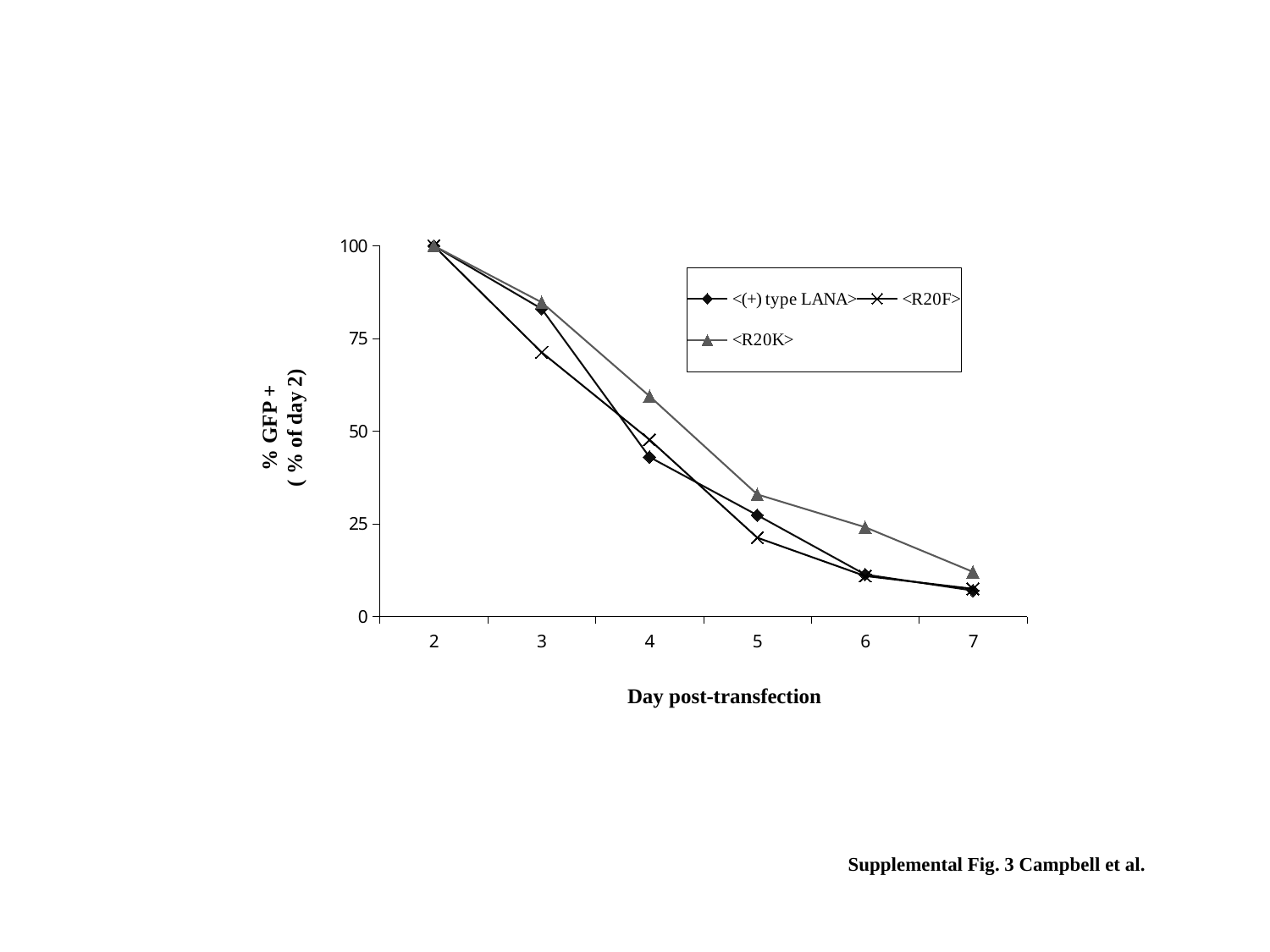
Is the value for <R20F> on day 3 greater or less than 75? less On day 5, which is larger: the value for <R20K> or the value for <R20F>? <R20K> Is the value for <(+) type LANA> on day 4 greater or less than 50? less What kind of chart is shown on the slide? line chart How many days are plotted along the x axis? 6 Do the values for <R20K> rise or fall from day 2 to day 7? fall Is the value for <R20K> on day 4 greater or less than 50? greater Which series has the lowest value on day 3? <R20F> How many series does the legend list? 3 Which series has the highest value on day 7? <R20K> What is the title of the x axis? Day post-transfection What is the value for <R20K> on day 2? 100